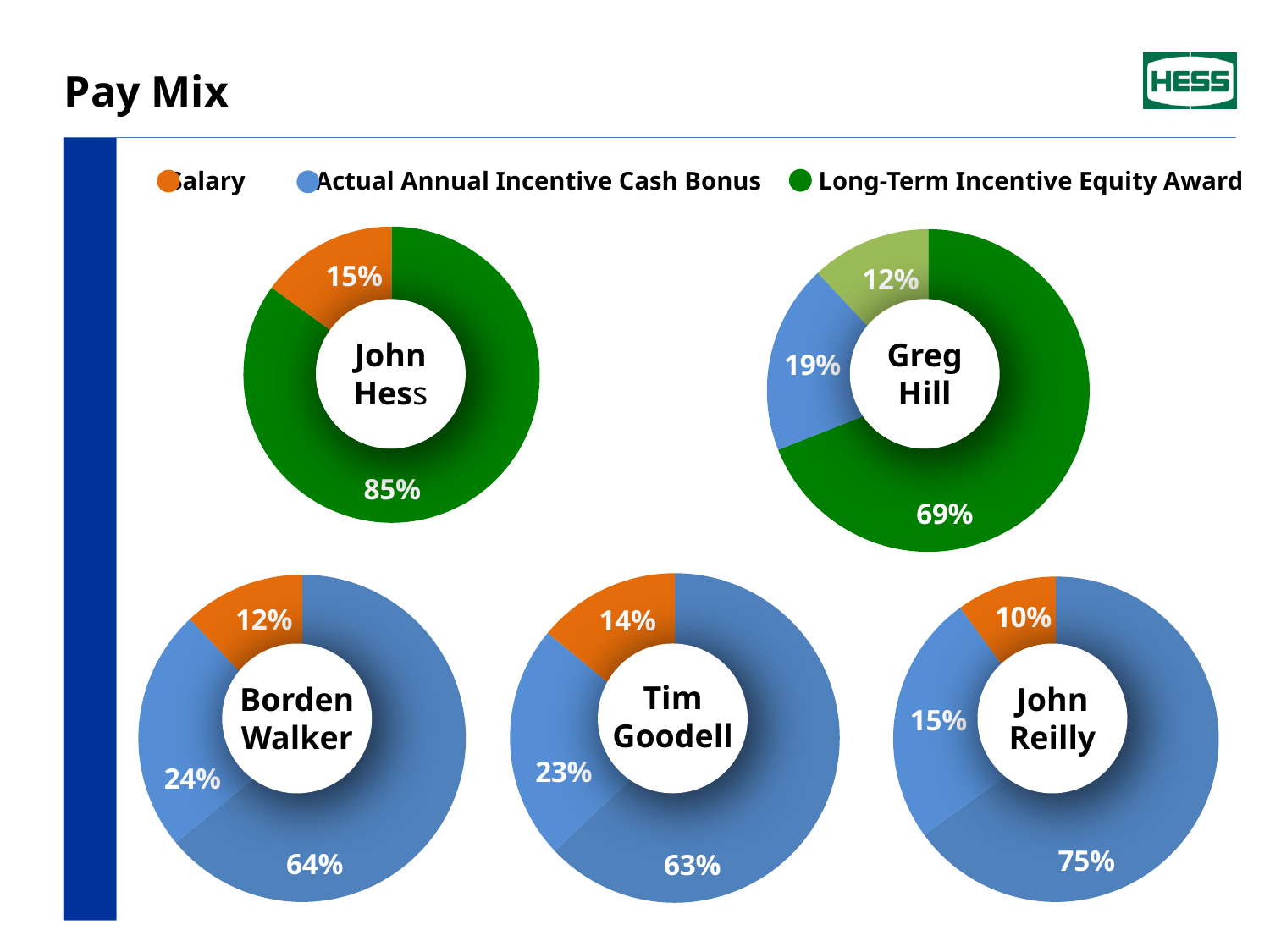
Which is larger: the largest slice in the Borden Walker chart or the largest slice in the Tim Goodell chart? Borden Walker (64%) In the Greg Hill chart, what is the value of the smallest slice? 12% In the John Hess chart, what is the value of the largest slice? 85% How many donut charts are shown on the slide? 5 In the Tim Goodell chart, what is the value of the orange slice? 14% How many series does the legend at the top of the slide list? 3 In the Borden Walker chart, what is the difference between the largest slice and the 24% slice? 40% What type of chart is used to show each executive's pay mix on the slide? Donut (pie) chart In the John Hess chart, what is the value of the orange slice? 15% In the John Reilly chart, what is the value of the largest slice? 75% How many slices does the Greg Hill chart have? 3 In the Greg Hill chart, what is the value of the largest slice? 69%